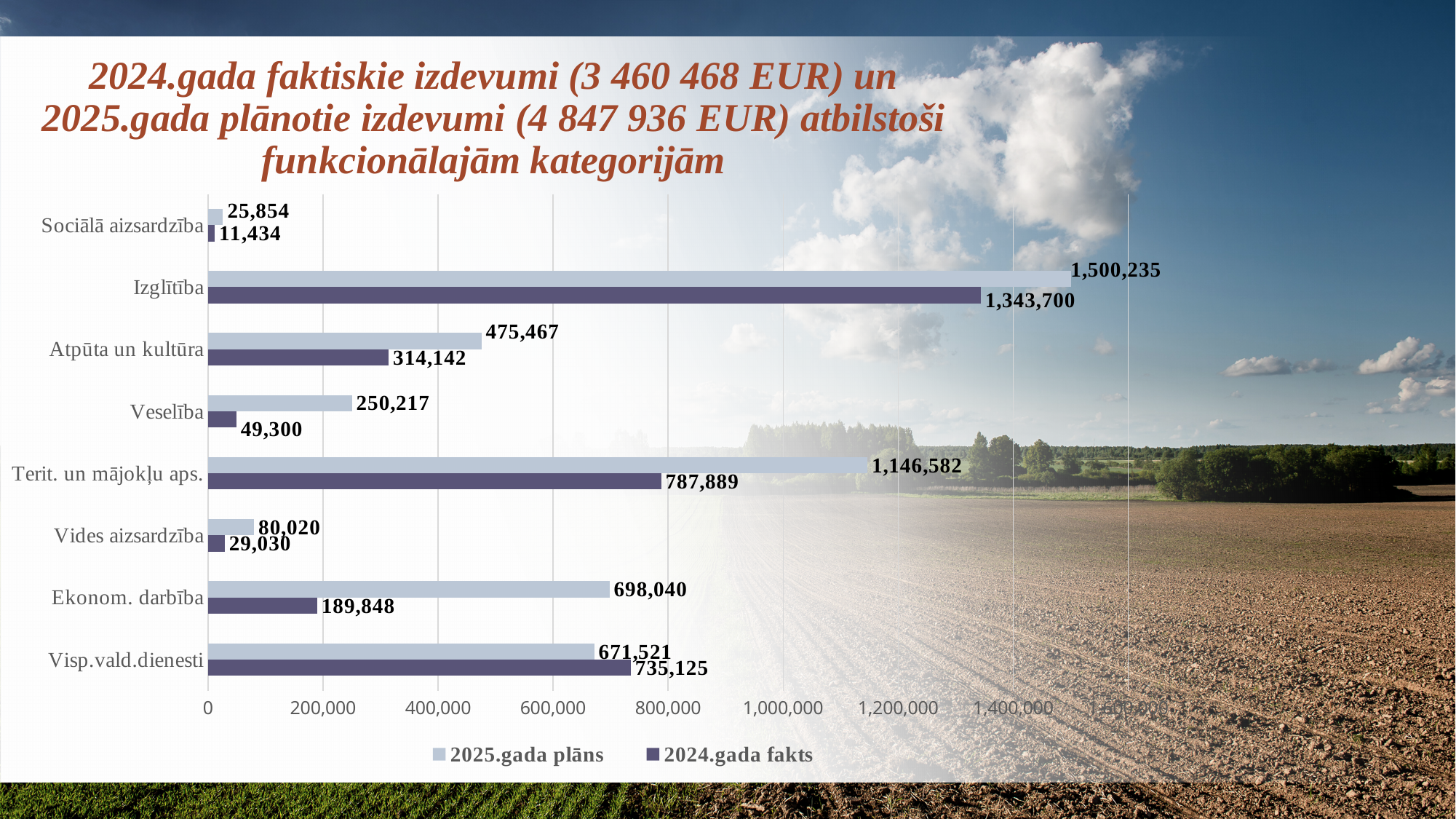
Which category has the highest 2024.gada fakts value? Izglītība What is the 2024.gada fakts value for Veselība? 49,300 What kind of chart is shown on the slide? Bar chart What is the difference between the 2024.gada fakts and 2025.gada plāns values for Visp.vald.dienesti? 63,604 What is the difference between the 2025.gada plāns and 2024.gada fakts values for Izglītība? 156,535 How many categories are shown on the chart? 8 How many series does the legend list? 2 What is the 2025.gada plāns value for Terit. un mājokļu aps.? 1,146,582 What is the 2025.gada plāns value for Izglītība? 1,500,235 For Visp.vald.dienesti, which is larger: the 2025.gada plāns value or the 2024.gada fakts value? 2024.gada fakts Is the 2025.gada plāns value for Ekonom. darbība greater or less than 600,000? greater Which category has the lowest 2025.gada plāns value? Sociālā aizsardzība